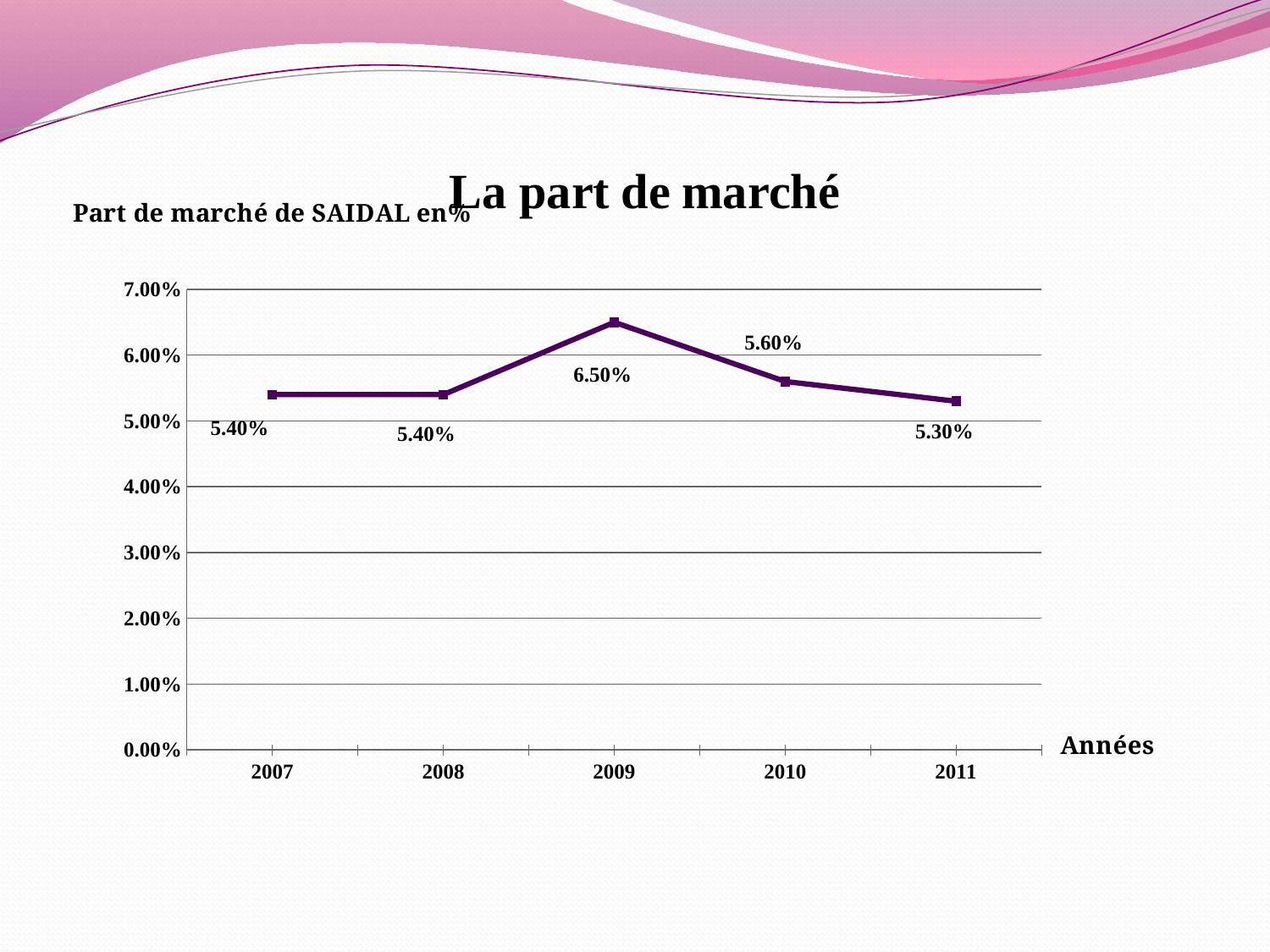
What is the difference between the market share in 2009 and in 2010? 0.90% What kind of chart is shown on the slide? line chart Which is larger, the market share in 2010 or in 2011? 2010 What is the difference between the market share in 2007 and in 2011? 0.10% What is the market share of SAIDAL in 2011? 5.30% What is the market share of SAIDAL in 2009? 6.50% Which year has the lowest market share? 2011 Is the market share in 2009 greater or less than 6.00%? greater What is the market share of SAIDAL in 2010? 5.60% Which year has the highest market share? 2009 What is the label on the x axis of the chart? Années How many years are plotted on the chart? 5